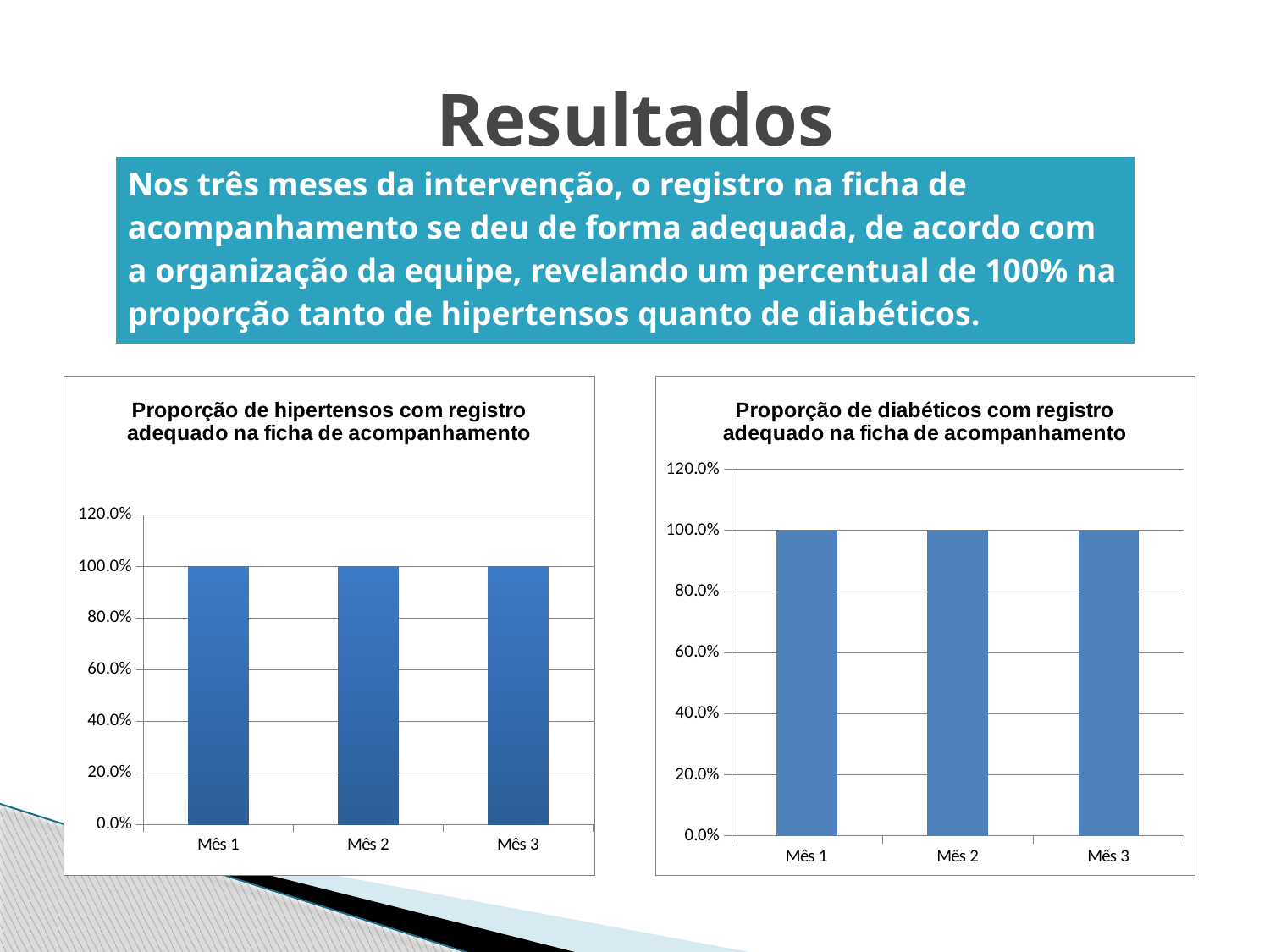
What kind of chart is the chart titled 'Proporção de diabéticos com registro adequado na ficha de acompanhamento'? Bar chart What is the title of the chart on the left? Proporção de hipertensos com registro adequado na ficha de acompanhamento In the chart titled 'Proporção de diabéticos com registro adequado na ficha de acompanhamento', what is the value for Mês 3? 100.0% In the chart on the right, what is the highest value shown on the y axis? 120.0% In the chart on the left, how many categories are shown on the x axis? 3 In the chart on the right, is the value for Mês 2 greater or less than 80.0%? greater In the chart titled 'Proporção de hipertensos com registro adequado na ficha de acompanhamento', what is the value for Mês 2? 100.0% In the chart on the left, do the values rise, fall or stay the same from Mês 1 to Mês 3? Stay the same In the chart on the right, how many bars are plotted? 3 In the chart titled 'Proporção de diabéticos com registro adequado na ficha de acompanhamento', what is the difference between the values for Mês 1 and Mês 2? 0.0% In the chart titled 'Proporção de hipertensos com registro adequado na ficha de acompanhamento', what is the value for Mês 1? 100.0% In the chart on the left, is the value for Mês 3 greater or less than 120.0%? less